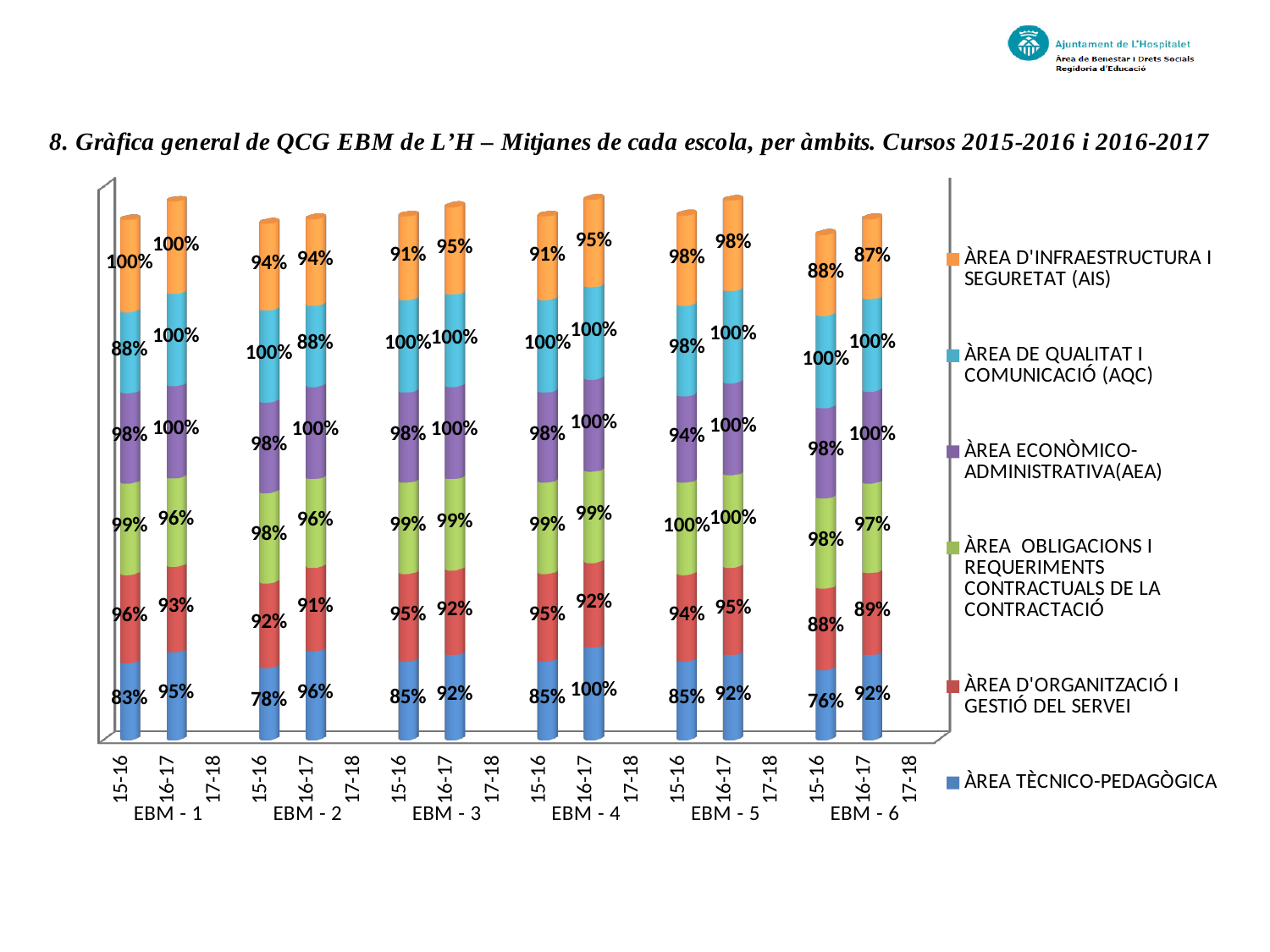
What is the difference between the ÀREA TÈCNICO-PEDAGÒGICA values for EBM - 2 in 16-17 and 15-16? 18% What is the value of ÀREA D'ORGANITZACIÓ I GESTIÓ DEL SERVEI for EBM - 5 in 16-17? 95% Which school and course has the lowest value for ÀREA D'INFRAESTRUCTURA I SEGURETAT (AIS)? EBM - 6, 16-17 What is the value of ÀREA D'INFRAESTRUCTURA I SEGURETAT (AIS) for EBM - 6 in 16-17? 87% How many schools (EBM groups) are shown on the x axis? 6 What is the value of ÀREA TÈCNICO-PEDAGÒGICA for EBM - 1 in 15-16? 83% Which is larger for EBM - 4: the ÀREA TÈCNICO-PEDAGÒGICA value in 15-16 or in 16-17? 16-17 What is the total of the stacked bar for EBM - 1 in 16-17? 584% How many series does the legend list? 6 Which school and course has the lowest value for ÀREA TÈCNICO-PEDAGÒGICA? EBM - 6, 15-16 What type of chart is shown on the slide? Stacked bar chart What is the value of ÀREA DE QUALITAT I COMUNICACIÓ (AQC) for EBM - 2 in 16-17? 88%